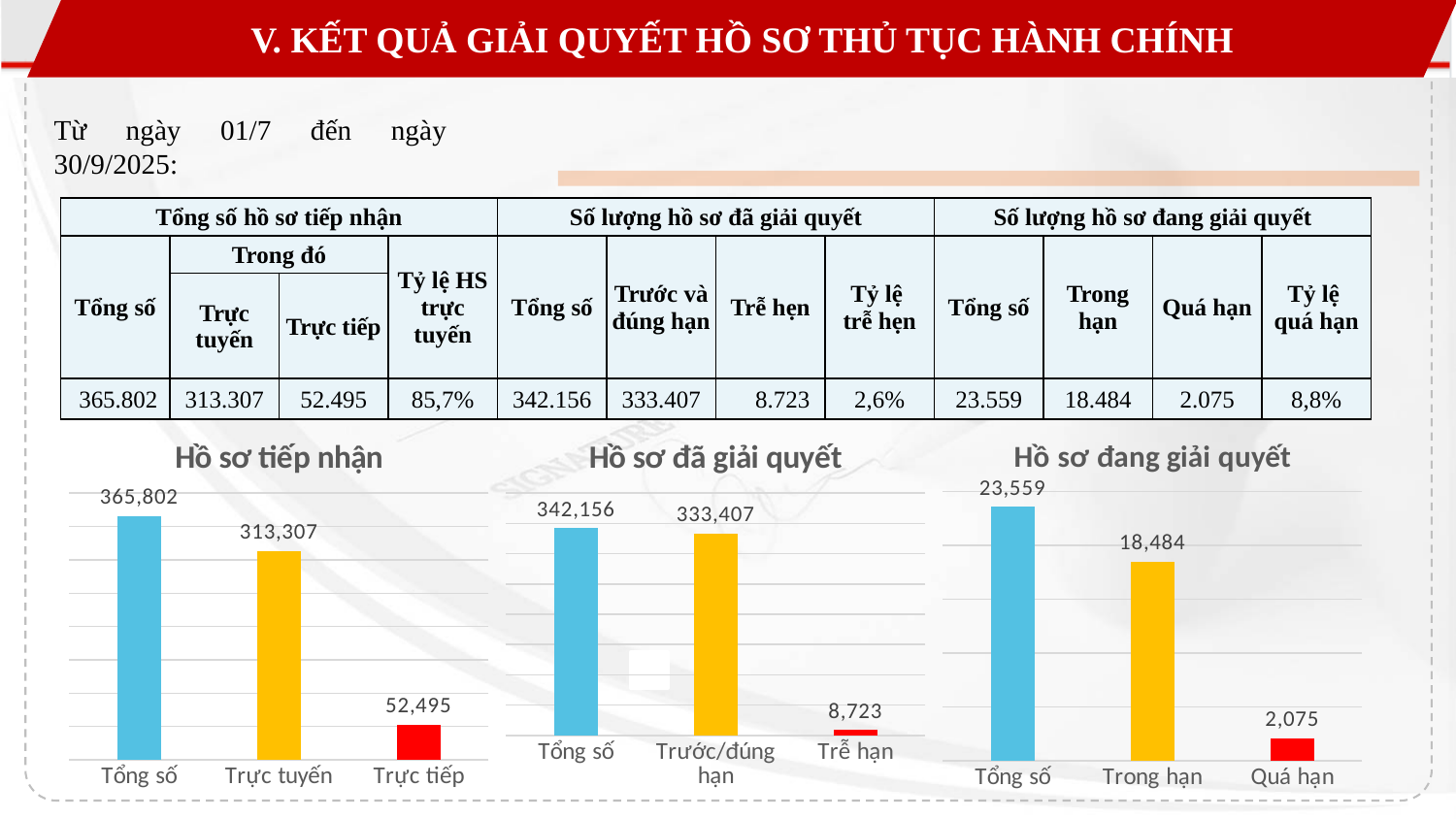
What type of chart is 'Hồ sơ tiếp nhận'? Bar chart In the 'Hồ sơ tiếp nhận' chart, which category has the lowest value? Trực tiếp In the 'Hồ sơ đang giải quyết' chart, what is the value for Trong hạn? 18,484 In the 'Hồ sơ tiếp nhận' chart, what is the value for Trực tuyến? 313,307 In the 'Hồ sơ đang giải quyết' chart, what is the difference between Tổng số and Trong hạn? 5,075 How many bars are in the 'Hồ sơ đang giải quyết' chart? 3 In the 'Hồ sơ đang giải quyết' chart, which is larger, Trong hạn or Quá hạn? Trong hạn In the 'Hồ sơ đã giải quyết' chart, which category has the highest value? Tổng số In the 'Hồ sơ đã giải quyết' chart, what is the value for Trễ hạn? 8,723 In the 'Hồ sơ tiếp nhận' chart, what is the difference between Tổng số and Trực tuyến? 52,495 In the 'Hồ sơ đã giải quyết' chart, what colour is the Trễ hạn bar? Red In the 'Hồ sơ đã giải quyết' chart, what is the difference between Tổng số and Trước/đúng hạn? 8,749